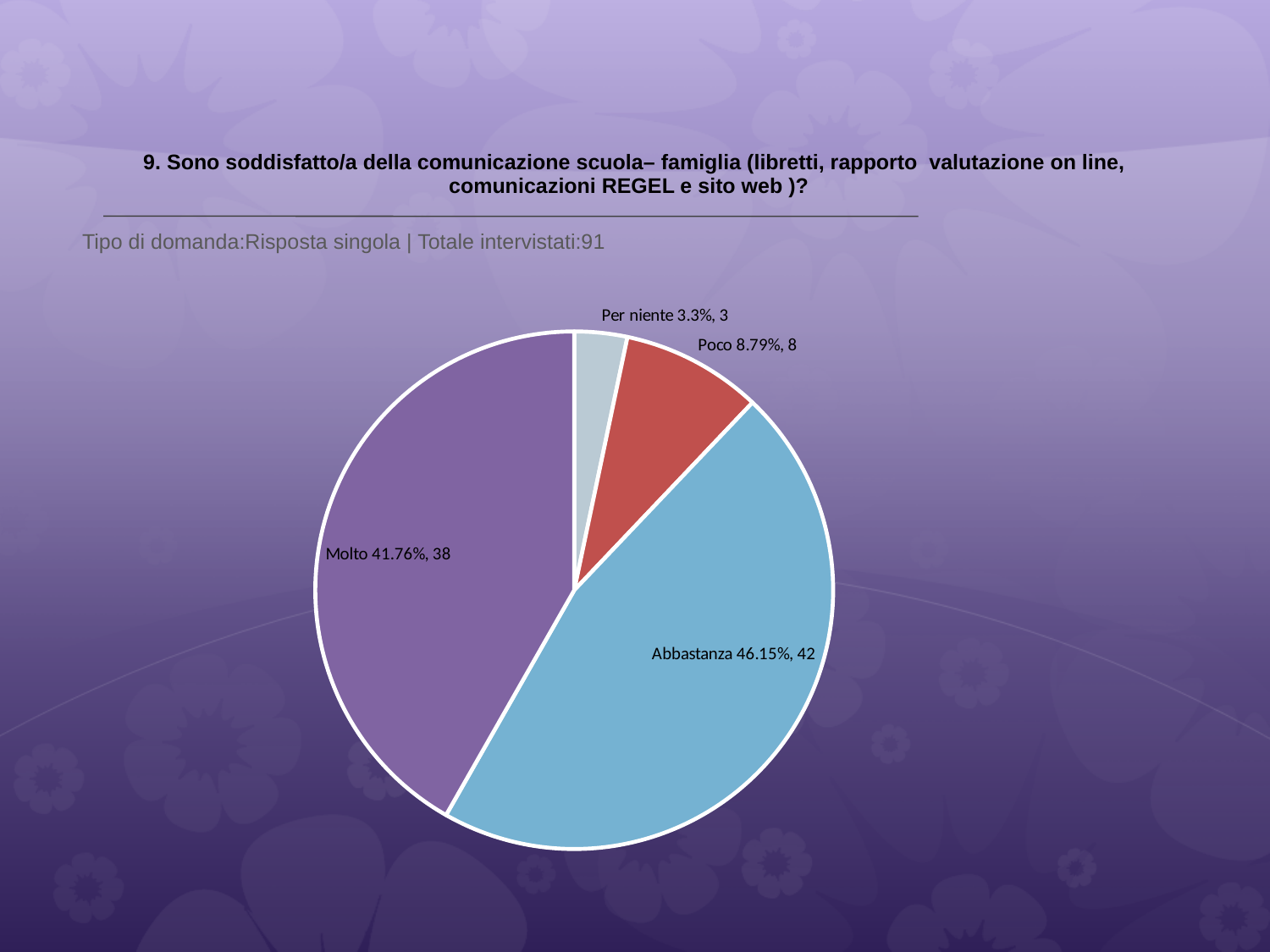
Which has more respondents, 'Poco' or 'Per niente'? Poco What percentage share does the 'Abbastanza' slice have? 46.15% What percentage share does the 'Poco' slice have? 8.79% Which category has the largest slice of the pie? Abbastanza How many respondents answered 'Molto'? 38 What is the total number of respondents across all slices? 91 What colour is the 'Abbastanza' slice? blue How many slices does the pie chart have? 4 How many respondents answered 'Per niente'? 3 What is the difference in respondent count between 'Abbastanza' and 'Molto'? 4 Which category has the smallest slice of the pie? Per niente What kind of chart is shown on the slide? pie chart